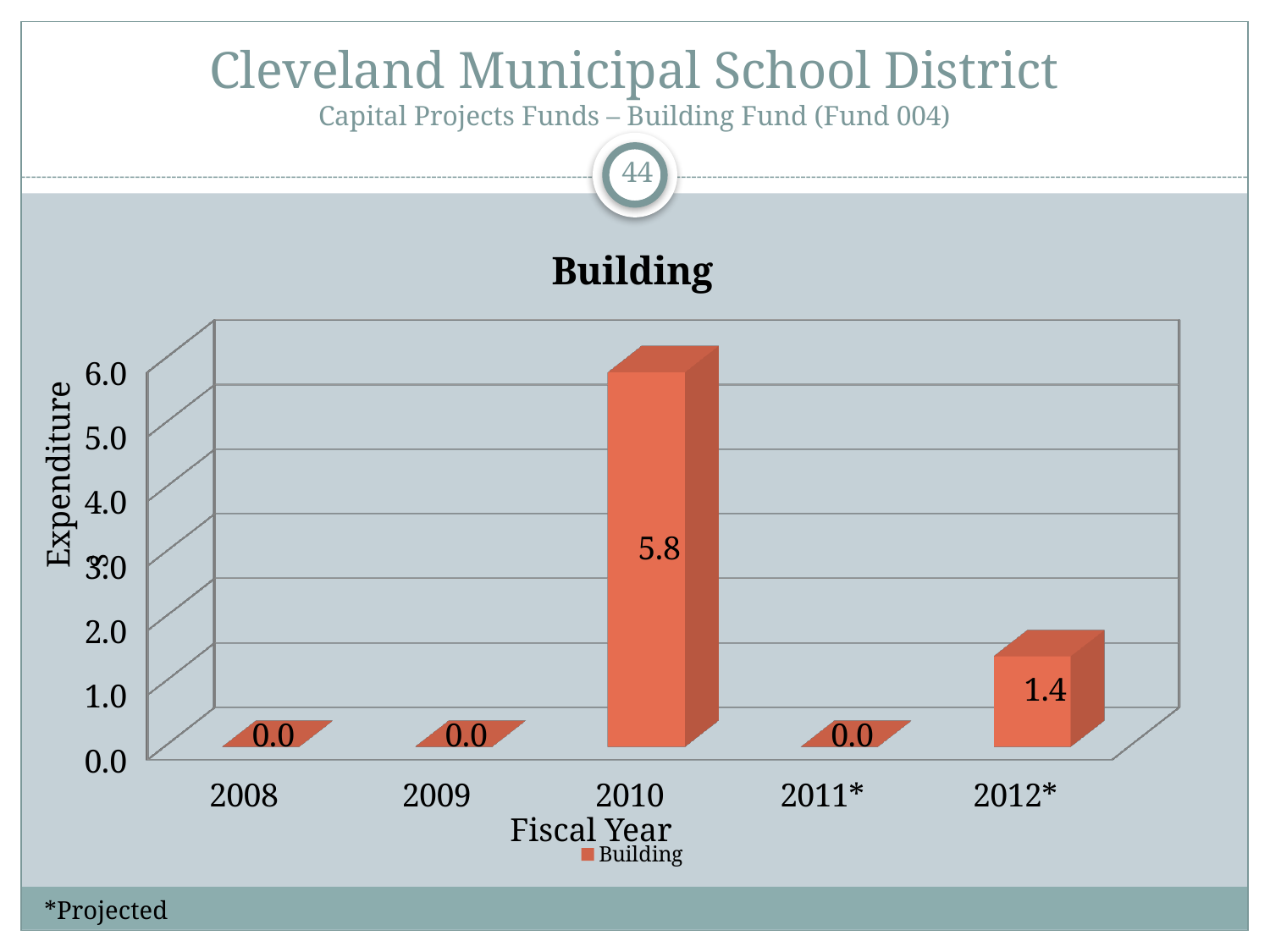
How many series does the chart legend list? 1 What is the Building expenditure for fiscal year 2012*? 1.4 Which is larger, the Building expenditure in 2010 or in 2012*? 2010 What kind of chart is shown on the slide? bar chart What is the Building expenditure for fiscal year 2010? 5.8 What is the difference between the Building expenditure in 2010 and in 2012*? 4.4 How many fiscal years are shown on the x axis of the chart? 5 What is the title of the chart? Building Is the Building expenditure for 2010 greater or less than 5.0? greater Which fiscal year has the highest Building expenditure? 2010 What is the Building expenditure for fiscal year 2008? 0.0 Is the Building expenditure for 2012* greater or less than 2.0? less